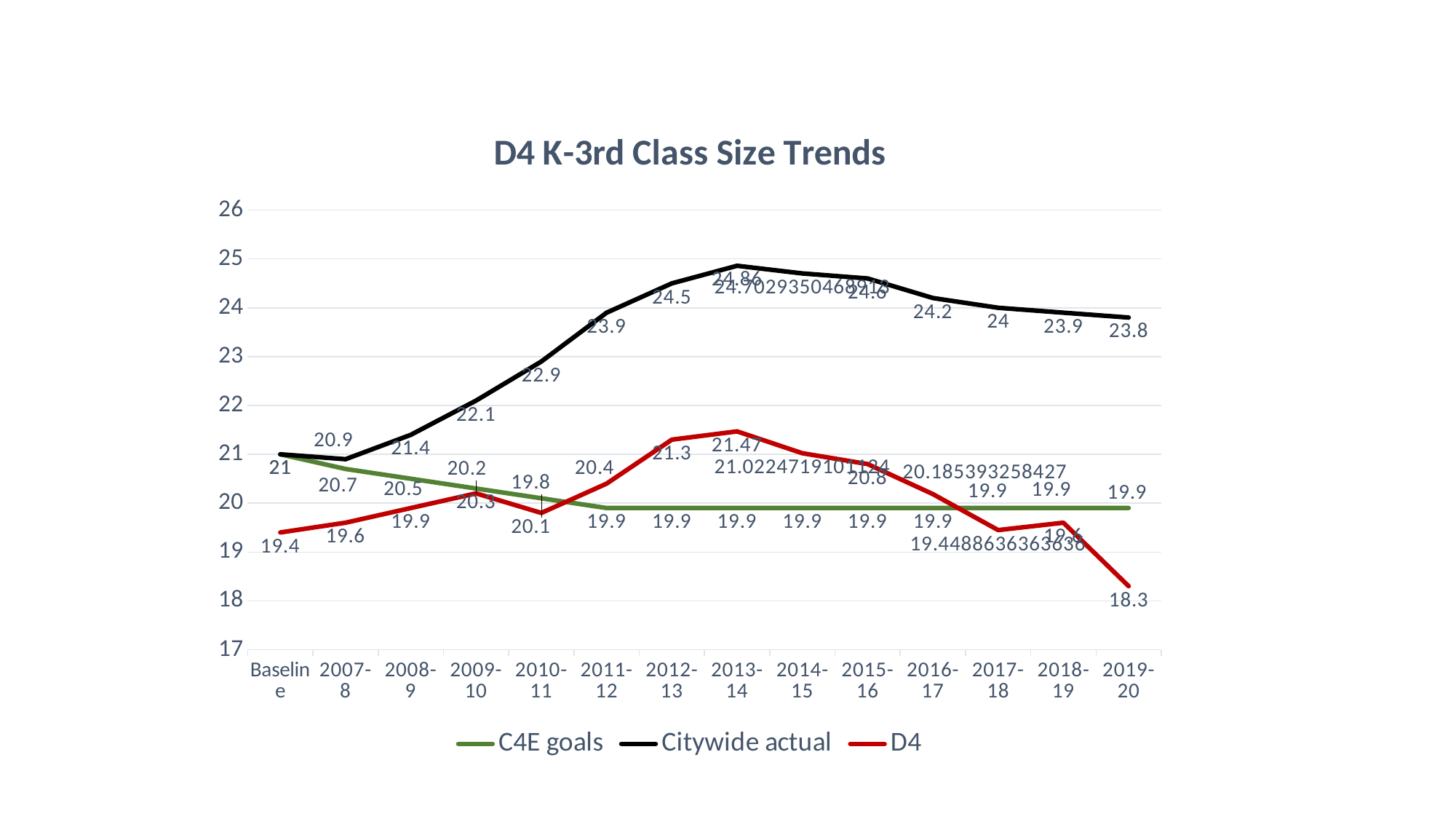
Which is larger in 2012-13, the Citywide actual value or the D4 value? Citywide actual What kind of chart is shown on the slide? line chart What is the D4 value at Baseline? 19.4 What is the Citywide actual value for 2013-14? 24.86 What is the D4 value for 2019-20? 18.3 How many series does the legend list? 3 What is the difference between the Citywide actual and D4 values for 2019-20? 5.5 What is the title of the chart? D4 K-3rd Class Size Trends How many categories are shown along the x axis? 14 What is the Citywide actual value for 2019-20? 23.8 In which year is the Citywide actual value highest? 2013-14 In which year is the D4 value lowest? 2019-20